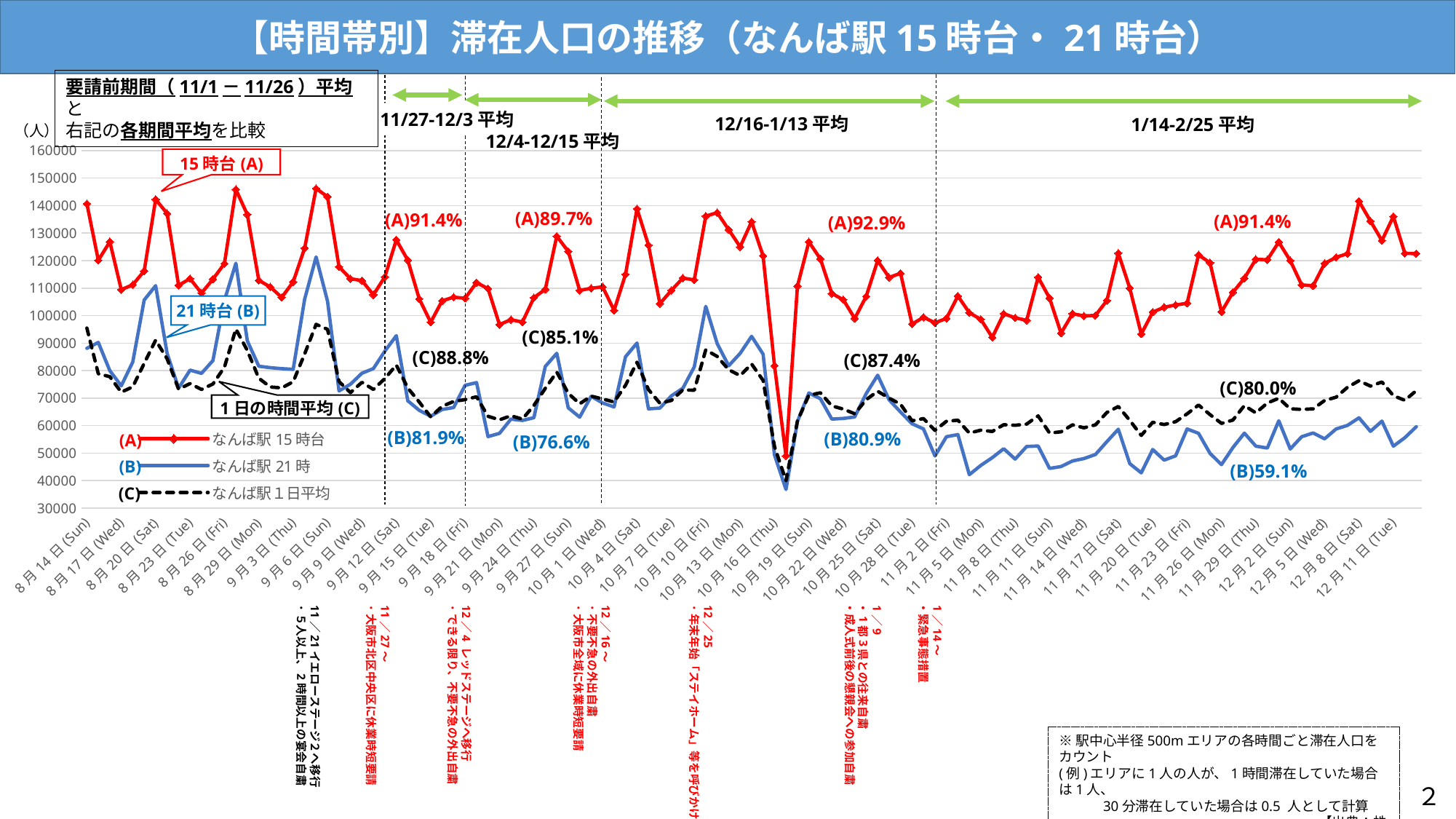
How many series does the chart's legend list? 3 Is the value for なんば駅15時台 on 8月14日 (Sun) greater or less than 130000? greater In which period is the (B) percentage the lowest? 1/14-2/25 平均 What kind of chart is shown on the slide? line chart In the 12/16-1/13 平均 period, which has the higher percentage, (A) or (B)? (A) In which period is the (A) percentage the highest? 12/16-1/13 平均 What percentage is shown for (C) in the 12/4-12/15 平均 period? 85.1% In the 1/14-2/25 平均 period, what is the difference between the (A) percentage and the (C) percentage? 11.4 percentage points What percentage is shown for (A) in the 11/27-12/3 平均 period? 91.4% In the 11/27-12/3 平均 period, what is the difference between the (C) percentage and the (B) percentage? 6.9 percentage points Which series is drawn as a black dashed line? なんば駅1日平均 What percentage is shown for (B) in the 1/14-2/25 平均 period? 59.1%